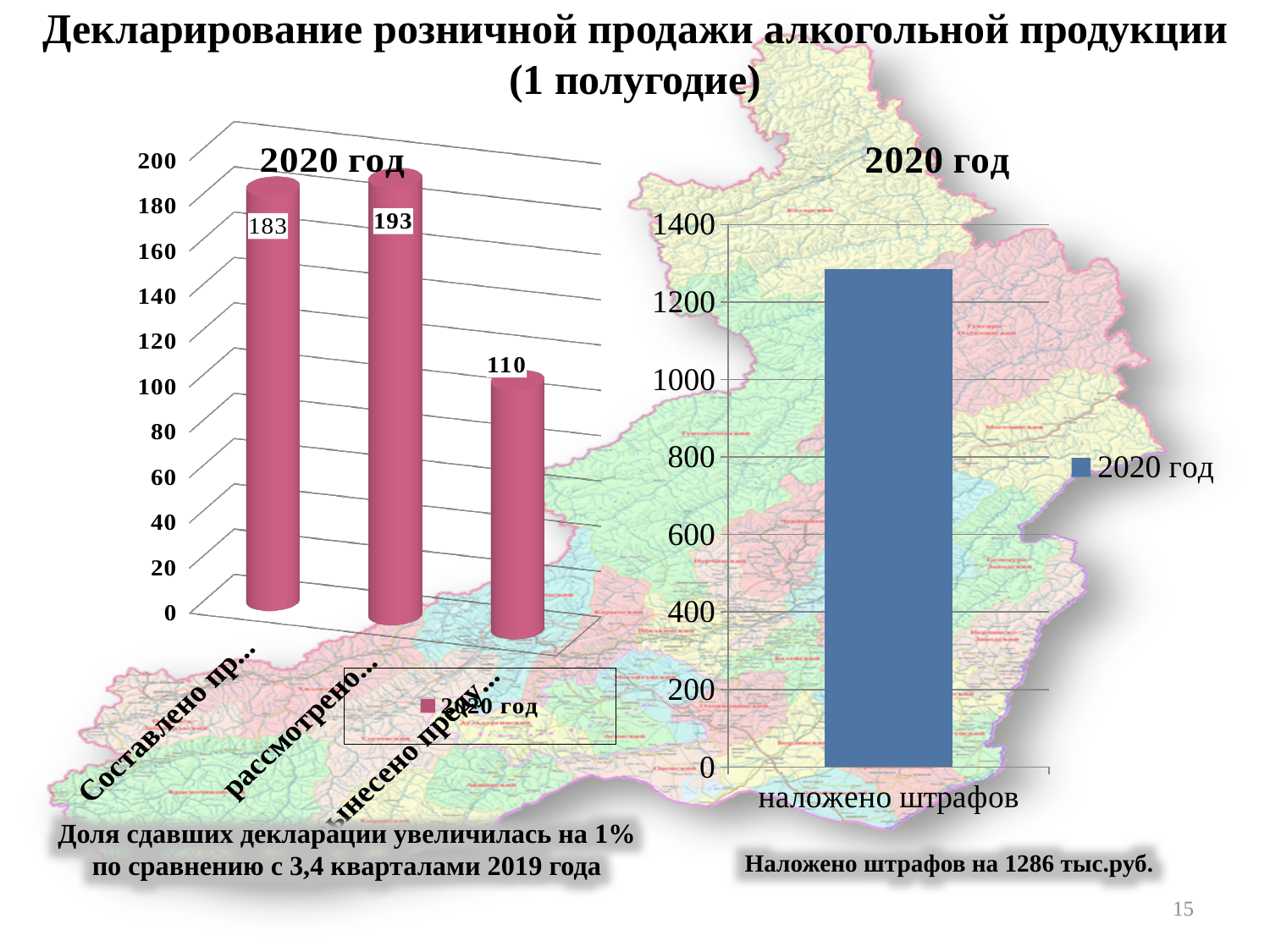
In the left chart, what is the difference between the second bar (193) and the first bar (183)? 10 In the right chart, is the value for "наложено штрафов" greater or less than 1200? greater In the left chart, what is the difference between the first bar (183) and the third bar (110)? 73 What kind of chart is the right chart with the category "наложено штрафов"? bar chart How many bars are plotted in the left chart? 3 In the left chart titled "2020 год", what is the value of the third (rightmost) bar? 110 In the left chart, which bar has the highest value? the second bar (193) In the left chart, which is larger: the first bar or the third bar? the first bar In the left chart, which bar has the lowest value? the third bar (110) How many series does the legend of the right chart list? 1 In the left chart titled "2020 год", what is the value of the second bar? 193 In the left chart titled "2020 год", what is the value of the first (leftmost) bar? 183